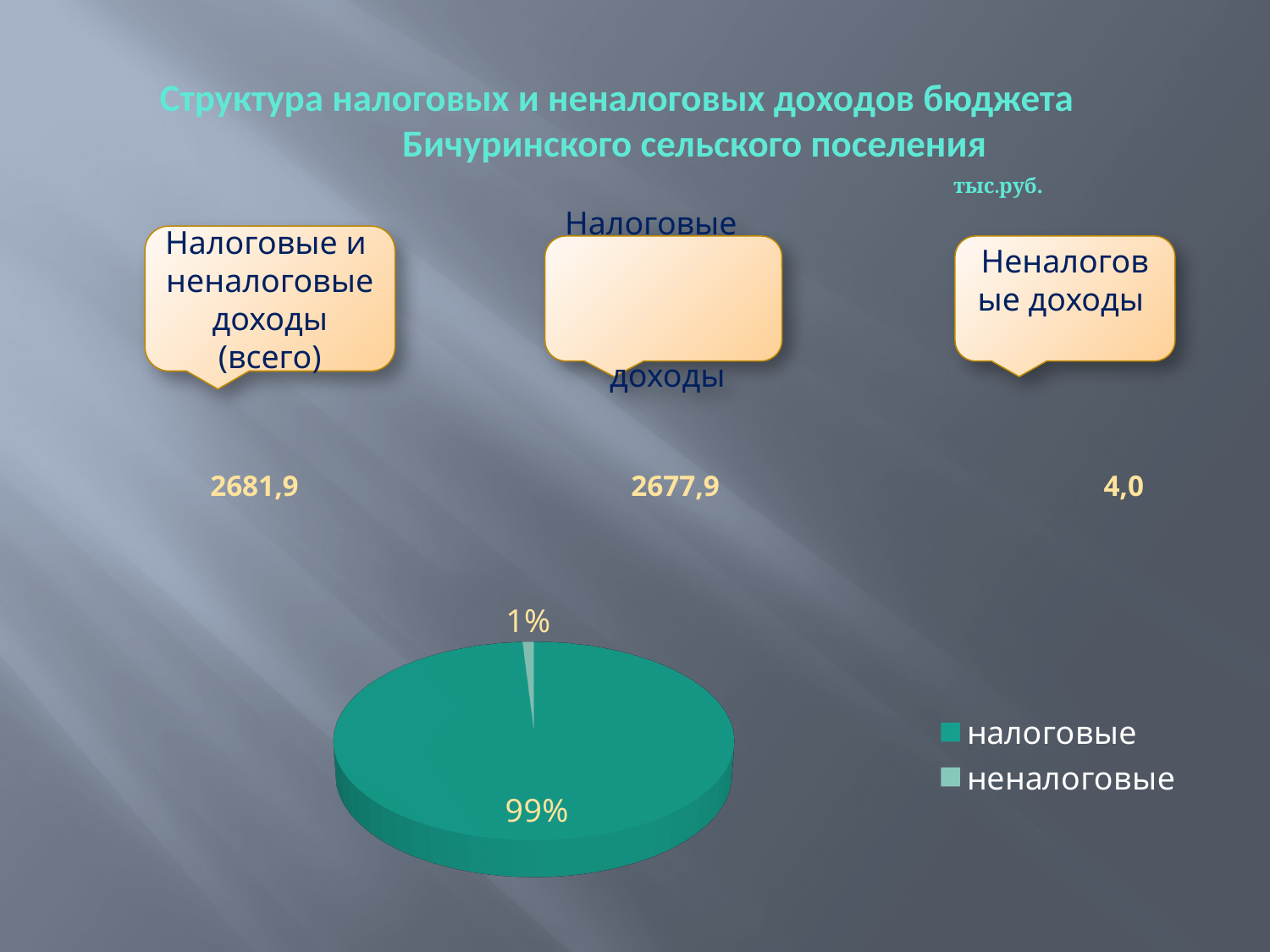
Is the share of the "налоговые" slice in the pie chart greater or less than 50%? greater How many entries does the legend of the pie chart list? 2 Which slice of the pie chart is the largest? налоговые What share of the pie chart does the "неналоговые" slice have? 1% What kind of chart is shown on the slide? pie chart What are the two legend entries of the pie chart? налоговые, неналоговые What is the difference in percentage points between the "налоговые" and "неналоговые" slices of the pie chart? 98 percentage points How many slices does the pie chart have? 2 What share of the pie chart does the "налоговые" slice have? 99% Which is larger in the pie chart, the "налоговые" slice or the "неналоговые" slice? налоговые Which slice of the pie chart is the smallest? неналоговые